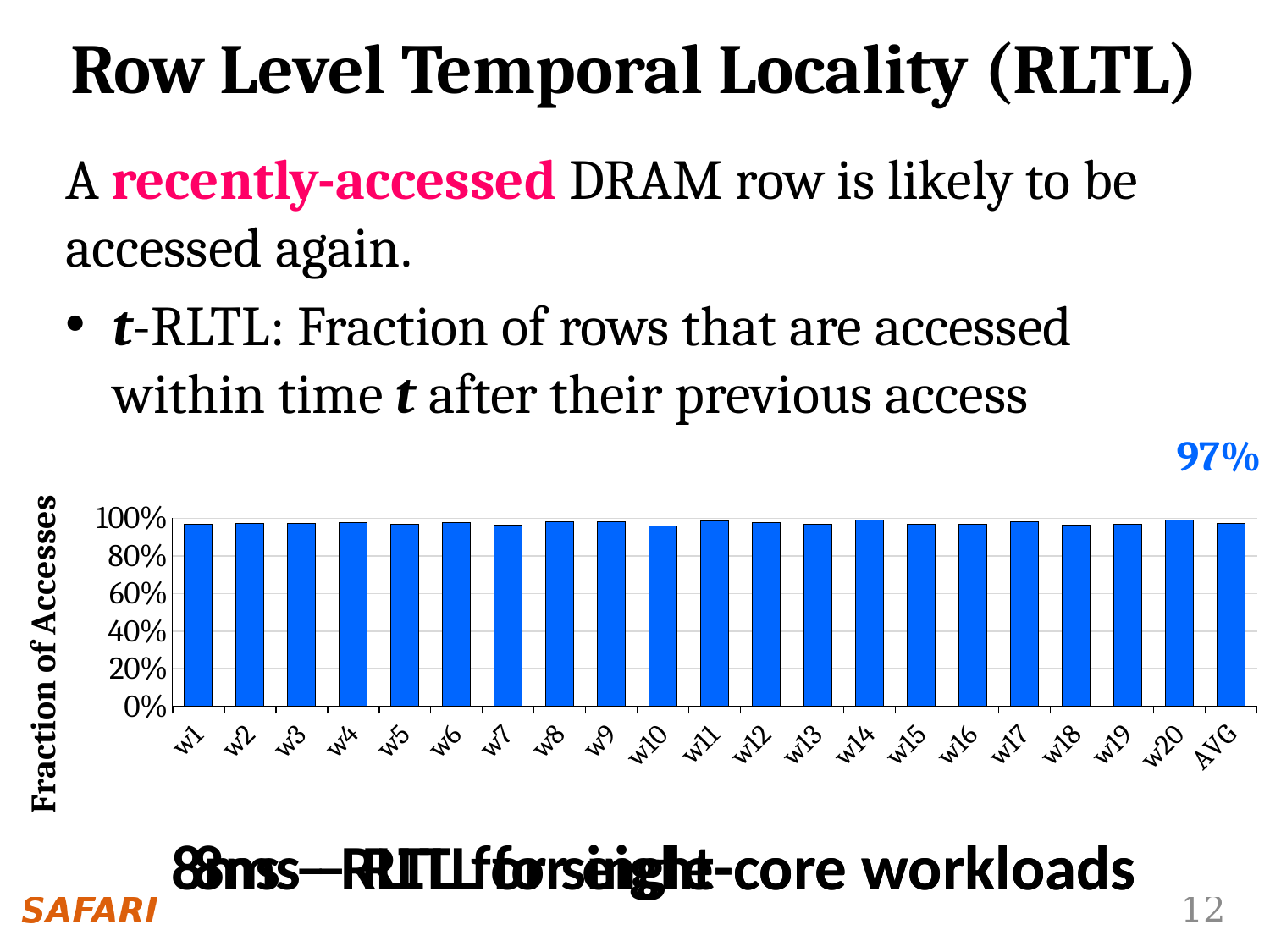
What is the value annotated for the AVG bar in the chart? 97% Do the values rise, fall, or stay roughly flat across the workloads w1 to w20? roughly flat What type of chart is shown on the slide? bar chart What is the highest tick value shown on the y axis? 100% What is the label of the last category on the x axis? AVG Is the value for w7 greater or less than 40%? greater Is the value for w20 greater or less than 80%? greater What is the label of the y axis of the chart? Fraction of Accesses Is the value for w10 greater or less than 60%? greater How many categories are shown along the x axis of the chart? 21